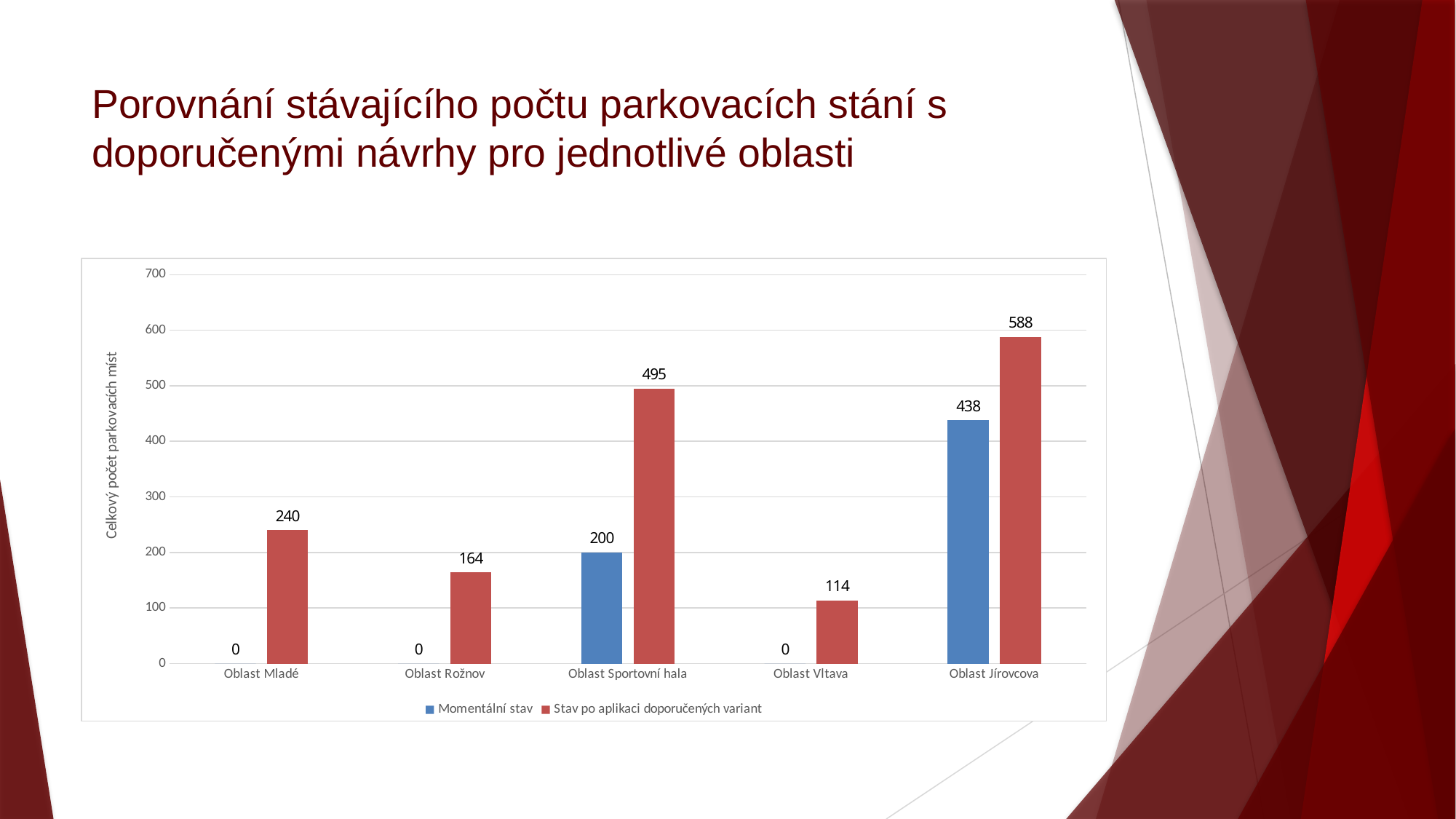
What is the value of 'Momentální stav' for Oblast Sportovní hala? 200 What is the label of the vertical axis? Celkový počet parkovacích míst Which category has the lowest value for 'Stav po aplikaci doporučených variant'? Oblast Vltava What is the value of 'Stav po aplikaci doporučených variant' for Oblast Vltava? 114 How many series does the legend list? 2 Which is larger: 'Stav po aplikaci doporučených variant' for Oblast Mladé or for Oblast Rožnov? Oblast Mladé What is the value of 'Stav po aplikaci doporučených variant' for Oblast Jírovcova? 588 What is the difference between 'Stav po aplikaci doporučených variant' and 'Momentální stav' for Oblast Sportovní hala? 295 Which category has the highest value for 'Stav po aplikaci doporučených variant'? Oblast Jírovcova What kind of chart is shown on the slide? bar chart How many categories are shown on the x axis? 5 What is the difference between 'Stav po aplikaci doporučených variant' and 'Momentální stav' for Oblast Jírovcova? 150